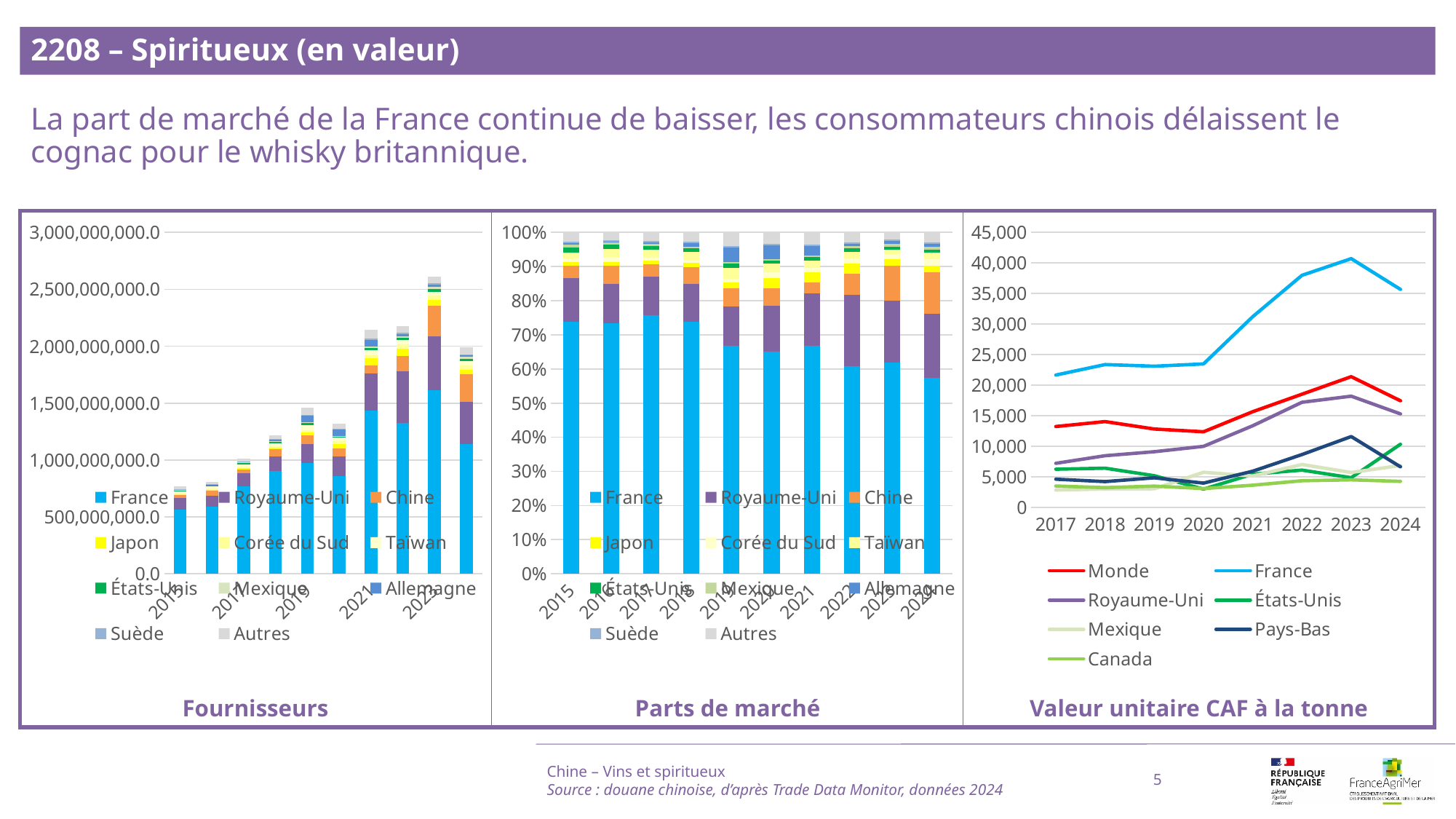
In the 'Parts de marché' chart, how many series does the legend list? 11 In the 'Parts de marché' chart, does the share of France rise or fall between 2017 and 2024? fall In the 'Fournisseurs' chart, which year has the highest total bar? 2023 In the 'Valeur unitaire CAF à la tonne' chart, which series has the highest value in 2023? France In the 'Fournisseurs' chart, is the total for 2023 greater or less than 2,500,000,000.0? greater What kind of chart is the 'Fournisseurs' chart on the left? stacked bar chart In the 'Valeur unitaire CAF à la tonne' chart, how many series does the legend list? 7 In the 'Fournisseurs' chart, how many years are shown on the x axis? 10 In the 'Fournisseurs' chart, which year has the lowest total bar? 2015 In the 'Valeur unitaire CAF à la tonne' chart, is the value for Monde in 2023 greater or less than 20,000? greater What kind of chart is the 'Valeur unitaire CAF à la tonne' chart on the right? line chart In the 'Parts de marché' chart, is the share of France in 2024 greater or less than 60%? less